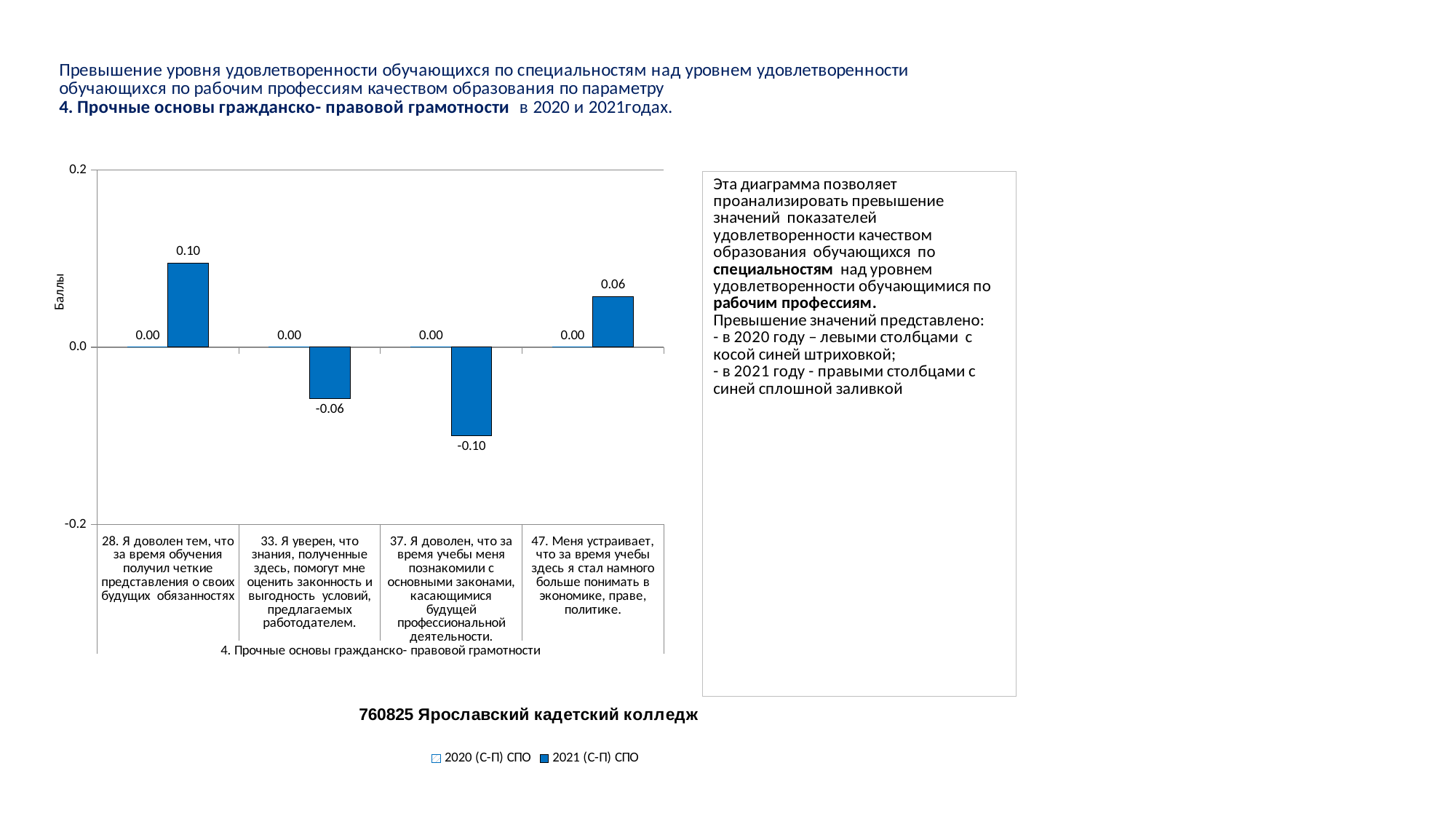
What type of chart is shown on the slide? bar chart How many items (categories) are shown on the x axis of the chart? 4 What is the 2020 (С-П) СПО value for item 28? 0.00 Which is larger for 2021 (С-П) СПО: the value for item 33 or the value for item 37? item 33 What is the 2021 (С-П) СПО value for item 33 ("Я уверен, что знания, полученные здесь, помогут мне оценить законность и выгодность условий, предлагаемых работодателем")? -0.06 What is the 2021 (С-П) СПО value for item 28 ("Я доволен тем, что за время обучения получил четкие представления о своих будущих обязанностях")? 0.10 What is the 2021 (С-П) СПО value for item 37 ("Я доволен, что за время учебы меня познакомили с основными законами...")? -0.10 Which item has the highest 2021 (С-П) СПО value? 28. Я доволен тем, что за время обучения получил четкие представления о своих будущих обязанностях How many series does the chart legend list? 2 Which item has the lowest 2021 (С-П) СПО value? 37. Я доволен, что за время учебы меня познакомили с основными законами, касающимися будущей профессиональной деятельности What is the 2021 (С-П) СПО value for item 47 ("Меня устраивает, что за время учебы здесь я стал намного больше понимать в экономике, праве, политике")? 0.06 What is the difference between the 2021 (С-П) СПО values for item 28 and item 47? 0.04